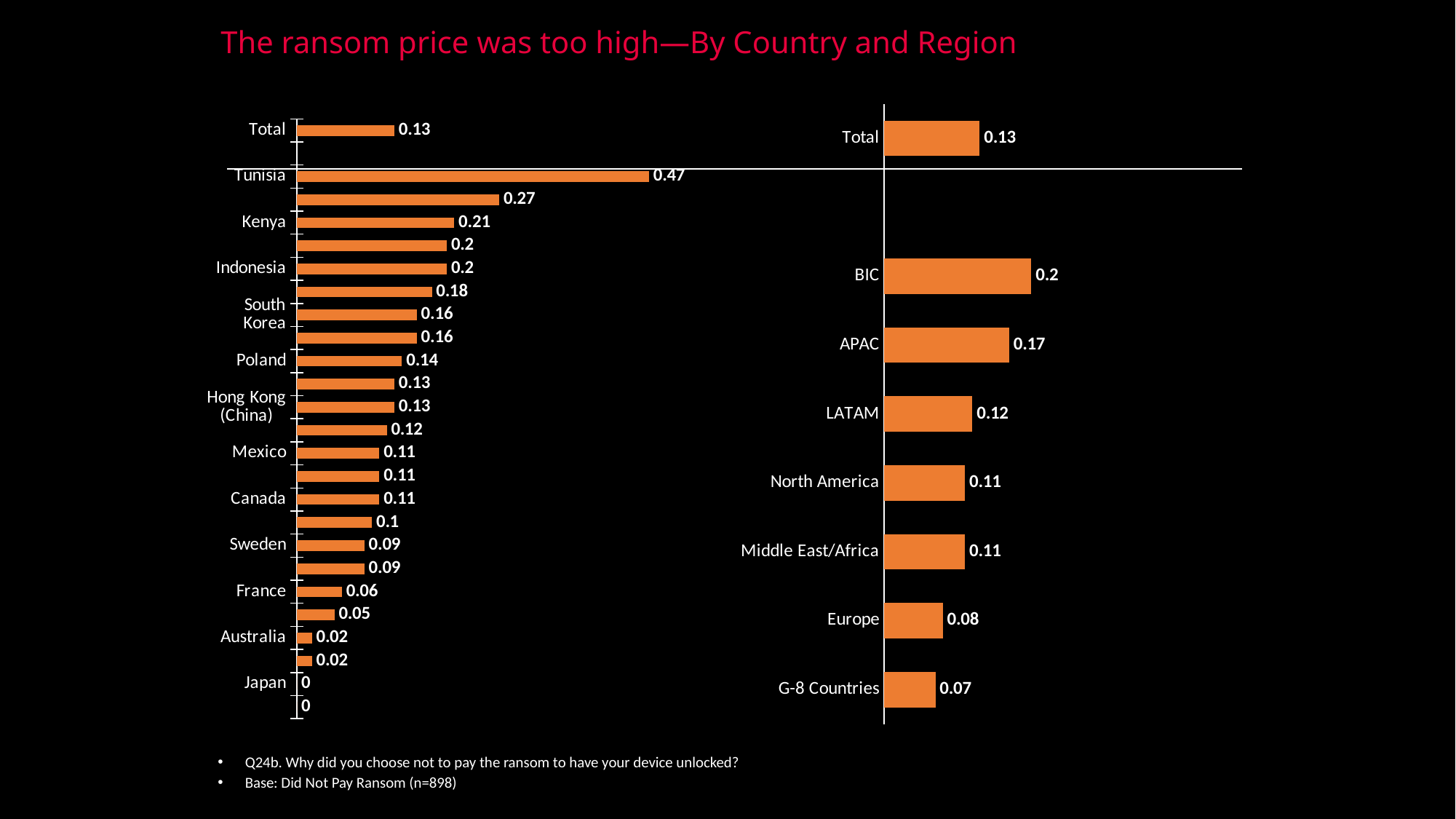
What type of chart is used on the right side of the slide? Bar chart In the right chart (by region), how many bars are shown? 8 In the left chart (by country), what is the difference between the values for Tunisia and Kenya? 0.26 In the left chart (by country), what is the value for Japan? 0 In the right chart (by region), which region has the highest value? BIC In the left chart (by country), what is the value for Tunisia? 0.47 In the left chart (by country), what is the value for Kenya? 0.21 In the right chart (by region), which category has the lowest value? G-8 Countries In the right chart (by region), what is the difference between the values for BIC and Europe? 0.12 In the left chart (by country), which is larger, the value for Poland or the value for Sweden? Poland In the right chart (by region), what is the value for APAC? 0.17 In the left chart (by country), which labelled country has the highest value? Tunisia